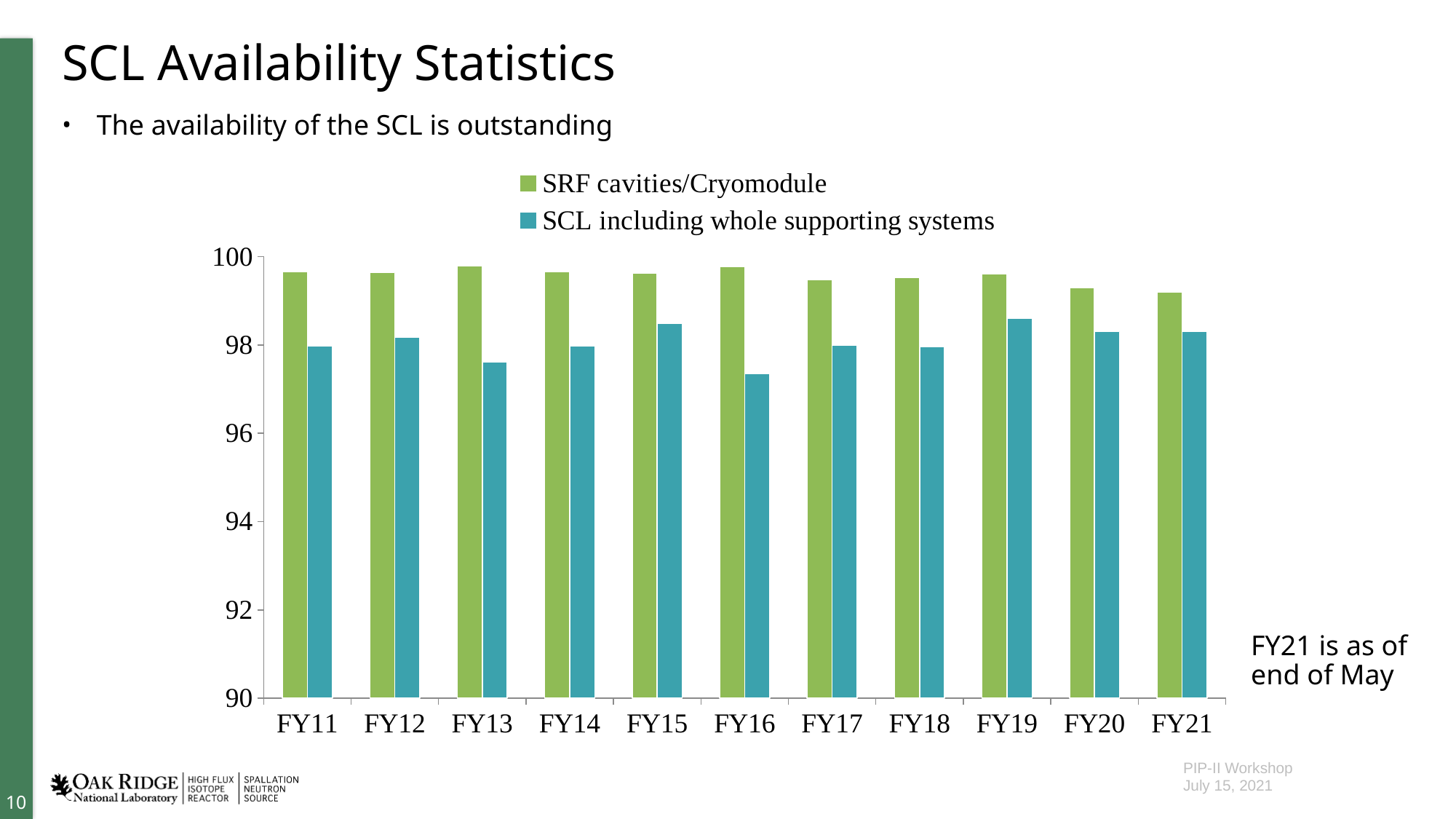
Is the value for SCL including whole supporting systems in FY19 greater or less than 98? greater Which is larger: the SCL including whole supporting systems value for FY13 or for FY15? FY15 Is the value for SCL including whole supporting systems in FY13 greater or less than 98? less How many series does the legend list? 2 According to the note next to the chart, as of when is the FY21 data? end of May Which fiscal year has the lowest value for SCL including whole supporting systems? FY16 What is the name of the series shown in green in the legend? SRF cavities/Cryomodule Is the value for SRF cavities/Cryomodule in FY11 greater or less than 98? greater What kind of chart is shown on the slide? bar chart In FY16, which series has the larger value: SRF cavities/Cryomodule or SCL including whole supporting systems? SRF cavities/Cryomodule How many fiscal years are shown on the x axis? 11